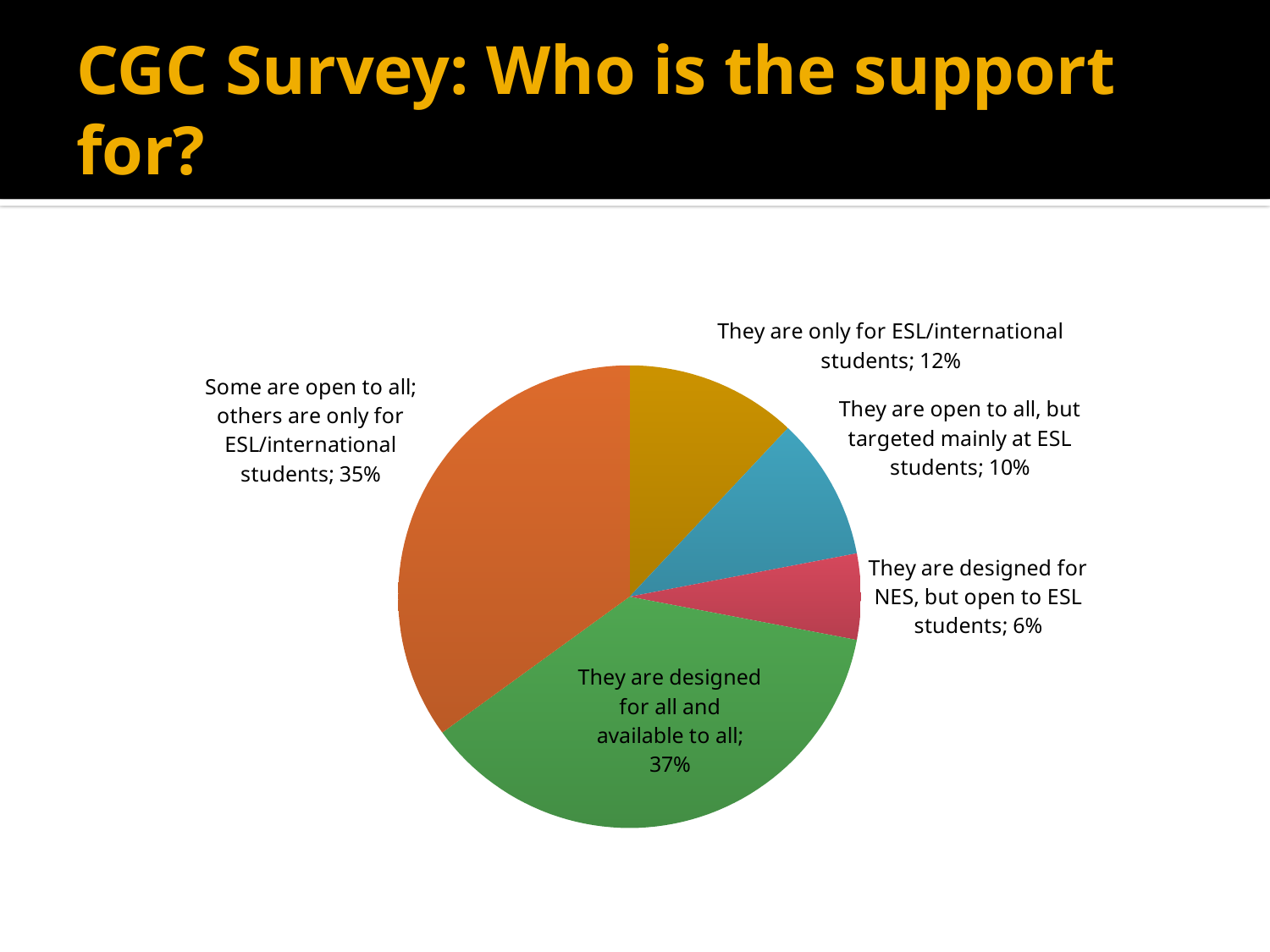
What share of the pie is 'Some are open to all; others are only for ESL/international students'? 35% Which is larger: the share for 'They are only for ESL/international students' or the share for 'They are open to all, but targeted mainly at ESL students'? They are only for ESL/international students Which category has the smallest slice of the pie? They are designed for NES, but open to ESL students What is the difference between the shares for 'They are only for ESL/international students' and 'They are designed for NES, but open to ESL students'? 6% Which category has the largest slice of the pie? They are designed for all and available to all What share of the pie is 'They are only for ESL/international students'? 12% What share of the pie is 'They are designed for all and available to all'? 37% How many slices does the pie chart have? 5 What kind of chart is shown on the slide? pie chart What is the title of the slide containing the pie chart? CGC Survey: Who is the support for?